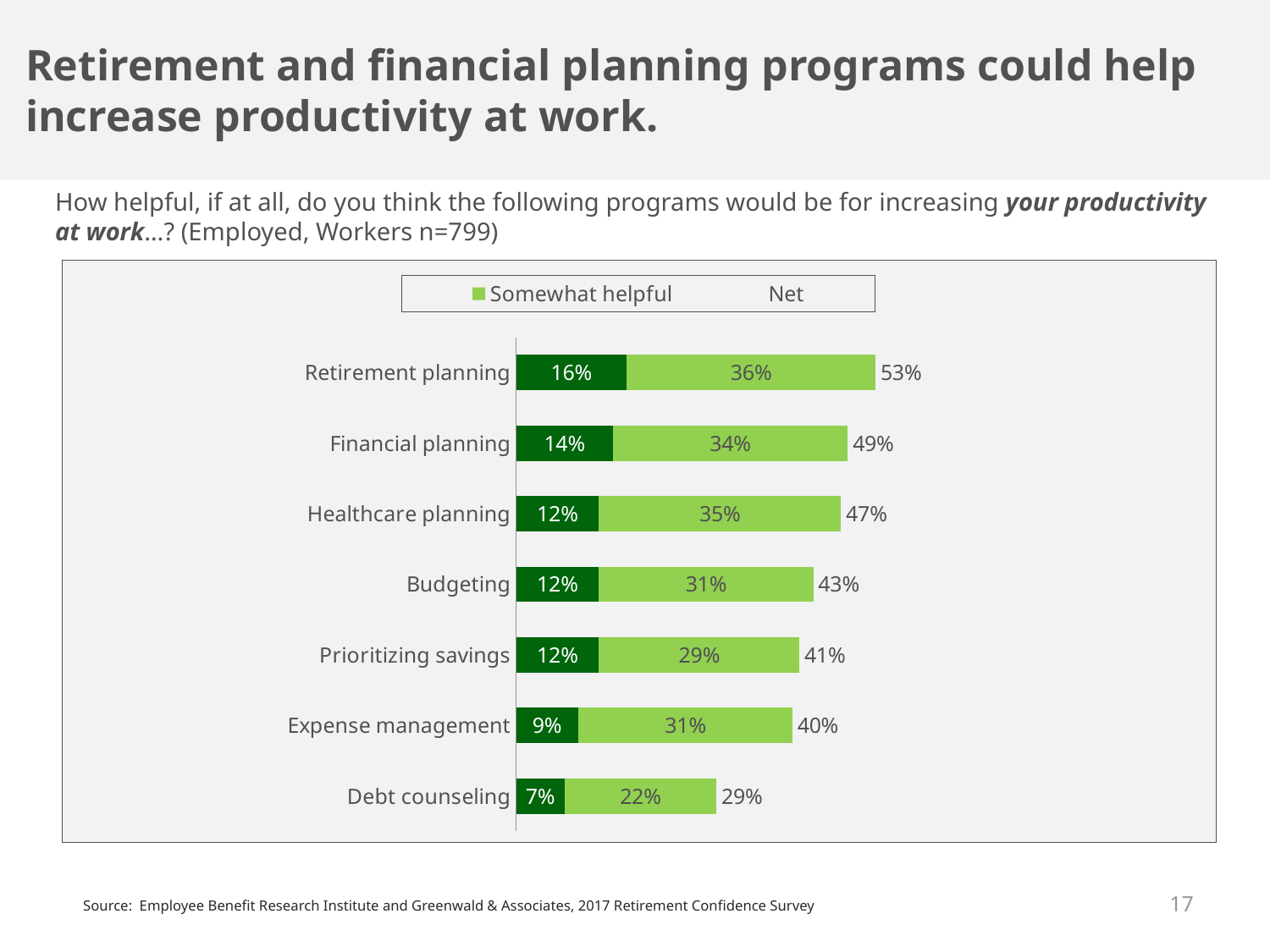
What colour represents 'Somewhat helpful' in the legend? Light green What is the 'Somewhat helpful' value for Debt counseling? 22% What is the 'Somewhat helpful' value for Healthcare planning? 35% What is the difference between the 'Somewhat helpful' values for Retirement planning and Debt counseling? 14 percentage points Which has a larger 'Somewhat helpful' value, Healthcare planning or Prioritizing savings? Healthcare planning Which program has the highest Net value? Retirement planning What is the Net value shown for Expense management? 40% What kind of chart is shown on the slide? Stacked bar chart What is the Net value shown for Budgeting? 43% How many programs are listed in the chart? 7 Which program has the lowest Net value? Debt counseling What is the difference between the Net values for Retirement planning and Financial planning? 4 percentage points